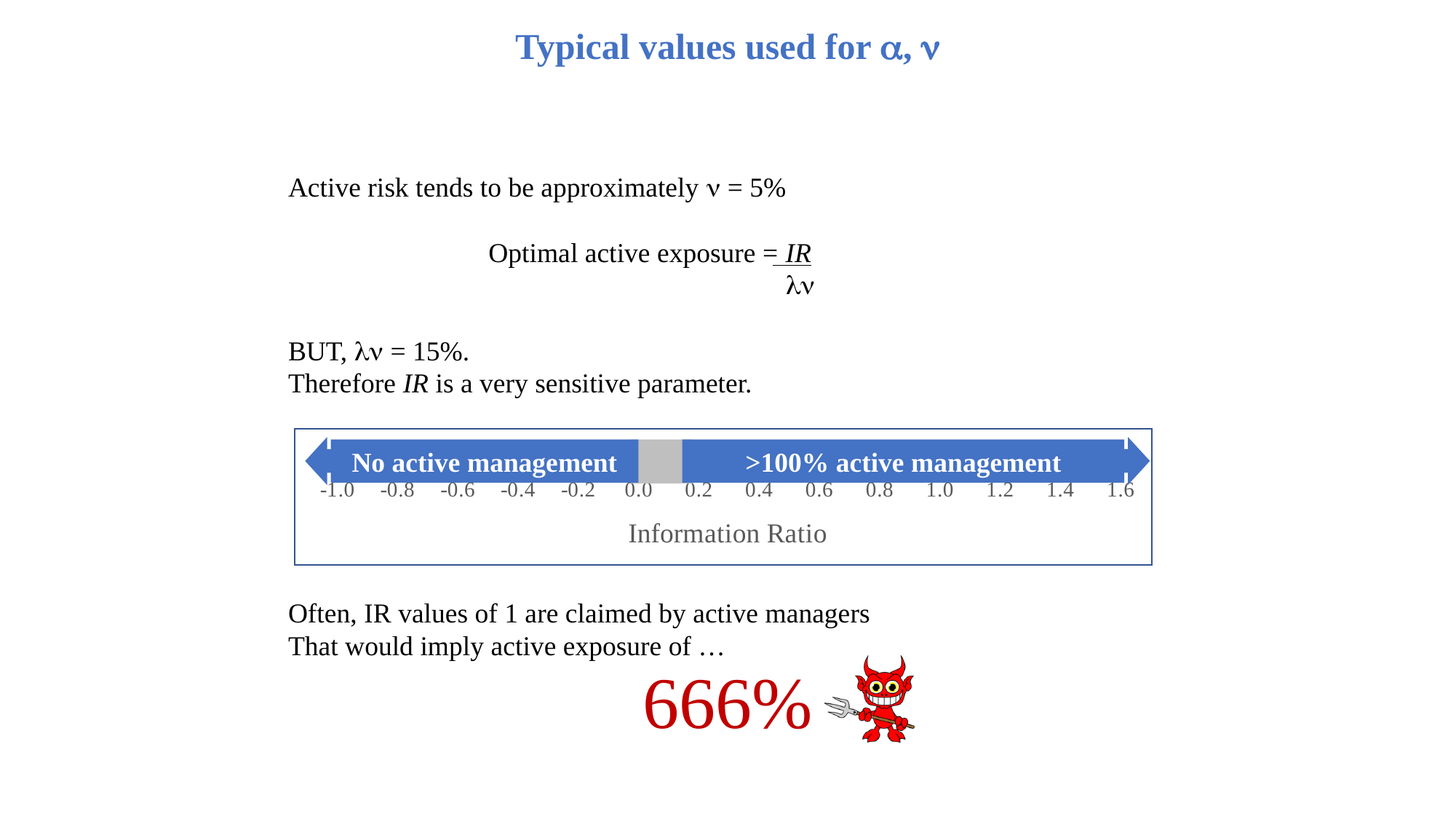
How many tick labels are printed along the Information Ratio axis? 14 What is the title of the horizontal axis in the chart? Information Ratio Which section of the arrow bar is wider, "No active management" or ">100% active management"? >100% active management Is the right edge of the grey band on the arrow bar greater or less than 0.2 on the Information Ratio axis? less What colour are the two labelled sections of the arrow bar? Blue What is the spacing between consecutive tick labels on the Information Ratio axis? 0.2 What label is printed on the right (positive) section of the arrow bar? >100% active management Is the left edge of the ">100% active management" section greater or less than 0.0 on the Information Ratio axis? greater What is the highest tick value shown on the Information Ratio axis? 1.6 What label is printed on the left (negative) section of the arrow bar? No active management What is the lowest tick value shown on the Information Ratio axis? -1.0